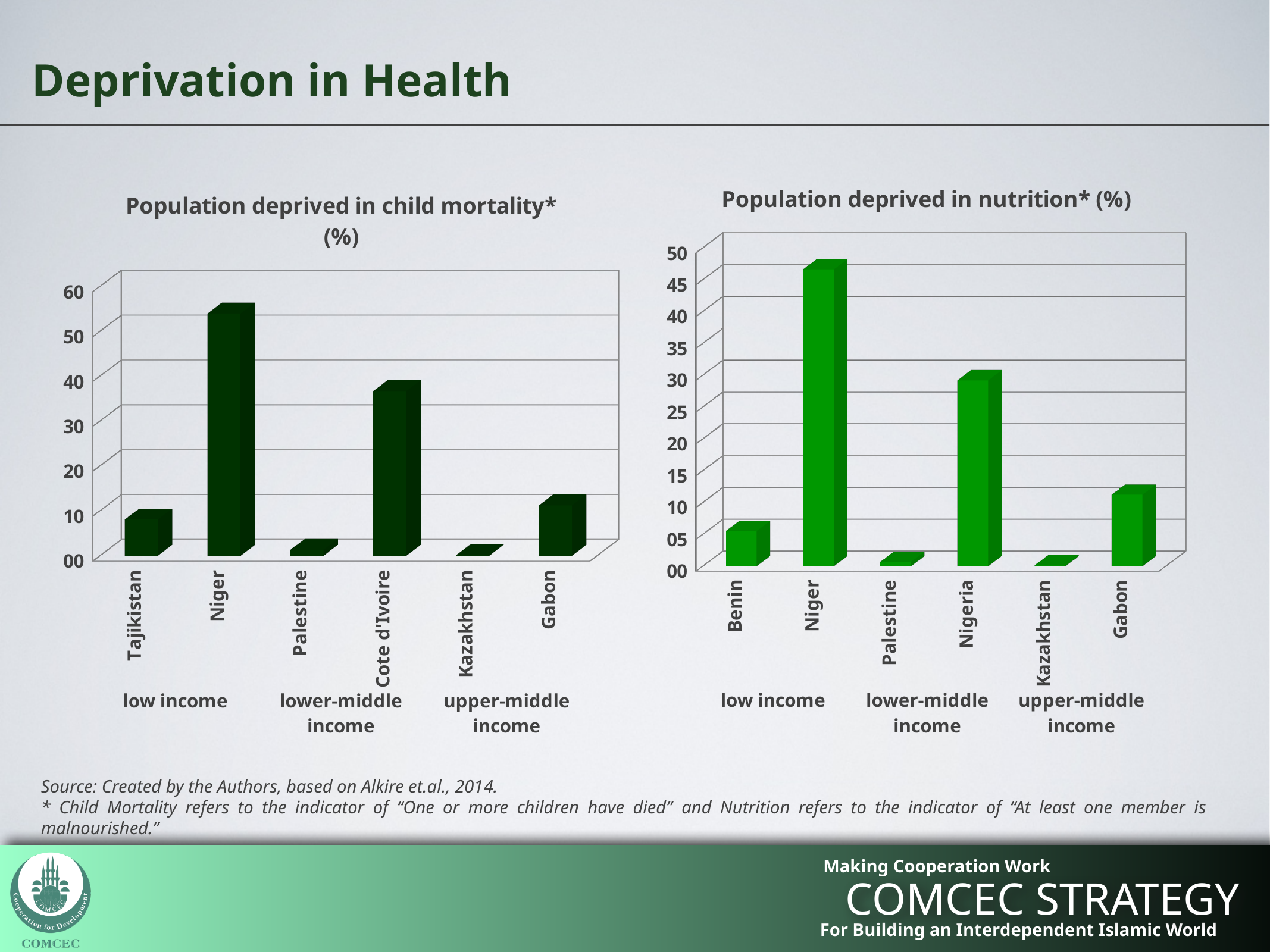
In the 'Population deprived in nutrition* (%)' chart, which is larger, the value for Nigeria or the value for Gabon? Nigeria In the 'Population deprived in nutrition* (%)' chart, is the value for Nigeria greater or less than 35? less In the 'Population deprived in child mortality* (%)' chart, is the value for Niger greater or less than 50? greater What kind of chart is the 'Population deprived in child mortality* (%)' chart? bar chart In the 'Population deprived in child mortality* (%)' chart, is the value for Cote d'Ivoire greater or less than 40? less In the 'Population deprived in nutrition* (%)' chart, which country has the highest value? Niger How many countries are shown in the 'Population deprived in nutrition* (%)' chart? 6 In the 'Population deprived in child mortality* (%)' chart, which country has the highest value? Niger In the 'Population deprived in child mortality* (%)' chart, which is larger, the value for Gabon or the value for Tajikistan? Gabon